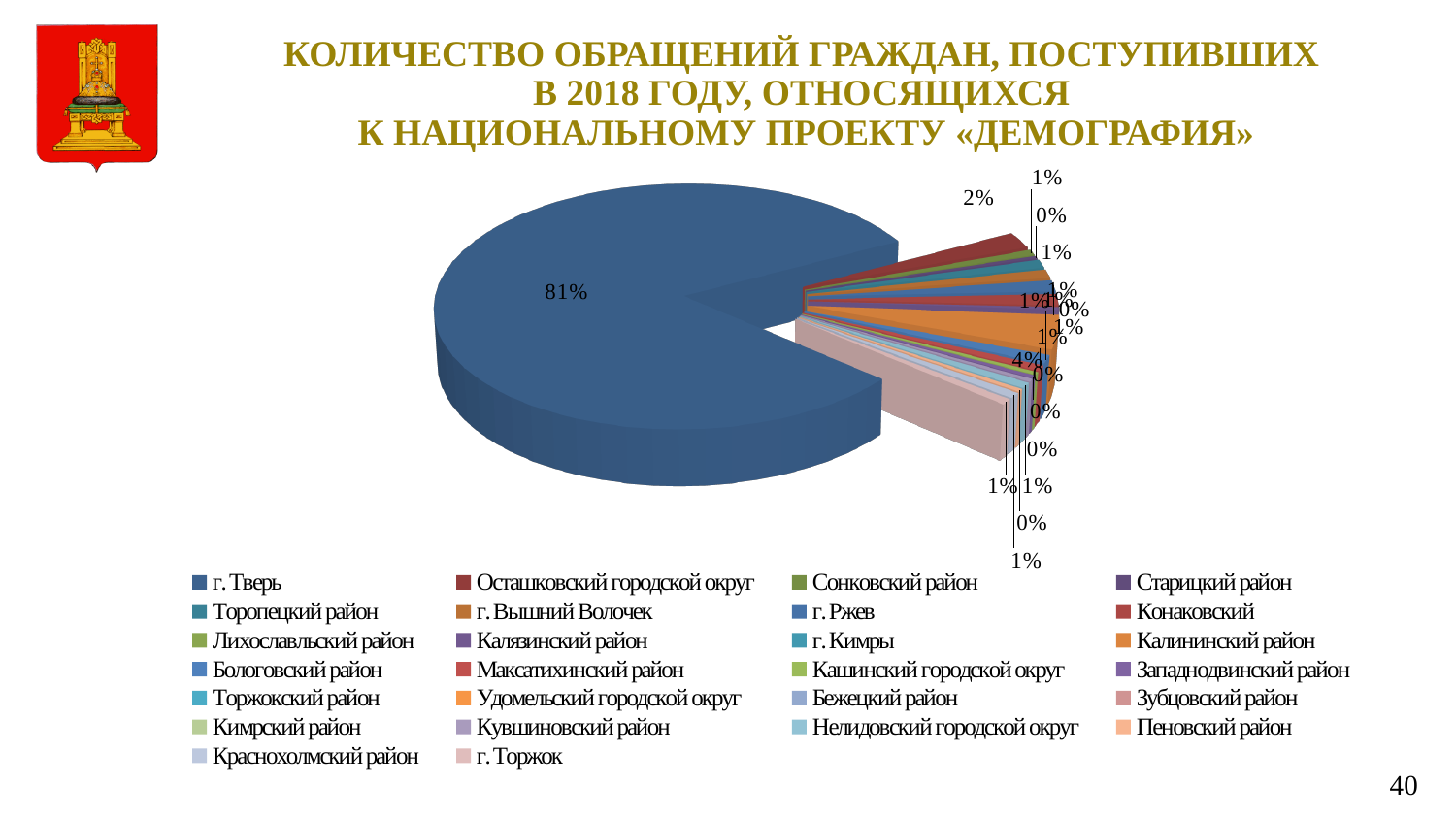
What is the difference between the shares of г. Тверь and Осташковский городской округ? 79% Which is larger, the slice for г. Тверь or the slice for Осташковский городской округ? г. Тверь How many categories does the legend list? 26 What colour is the slice for г. Тверь? dark blue What share of the pie does г. Тверь account for? 81% Which category has the largest slice of the pie? г. Тверь What percentage is shown for г. Тверь? 81% What is the title of the chart? Количество обращений граждан, поступивших в 2018 году, относящихся к национальному проекту «Демография» What percentage is shown for Осташковский городской округ? 2% What kind of chart is shown on the slide? pie chart